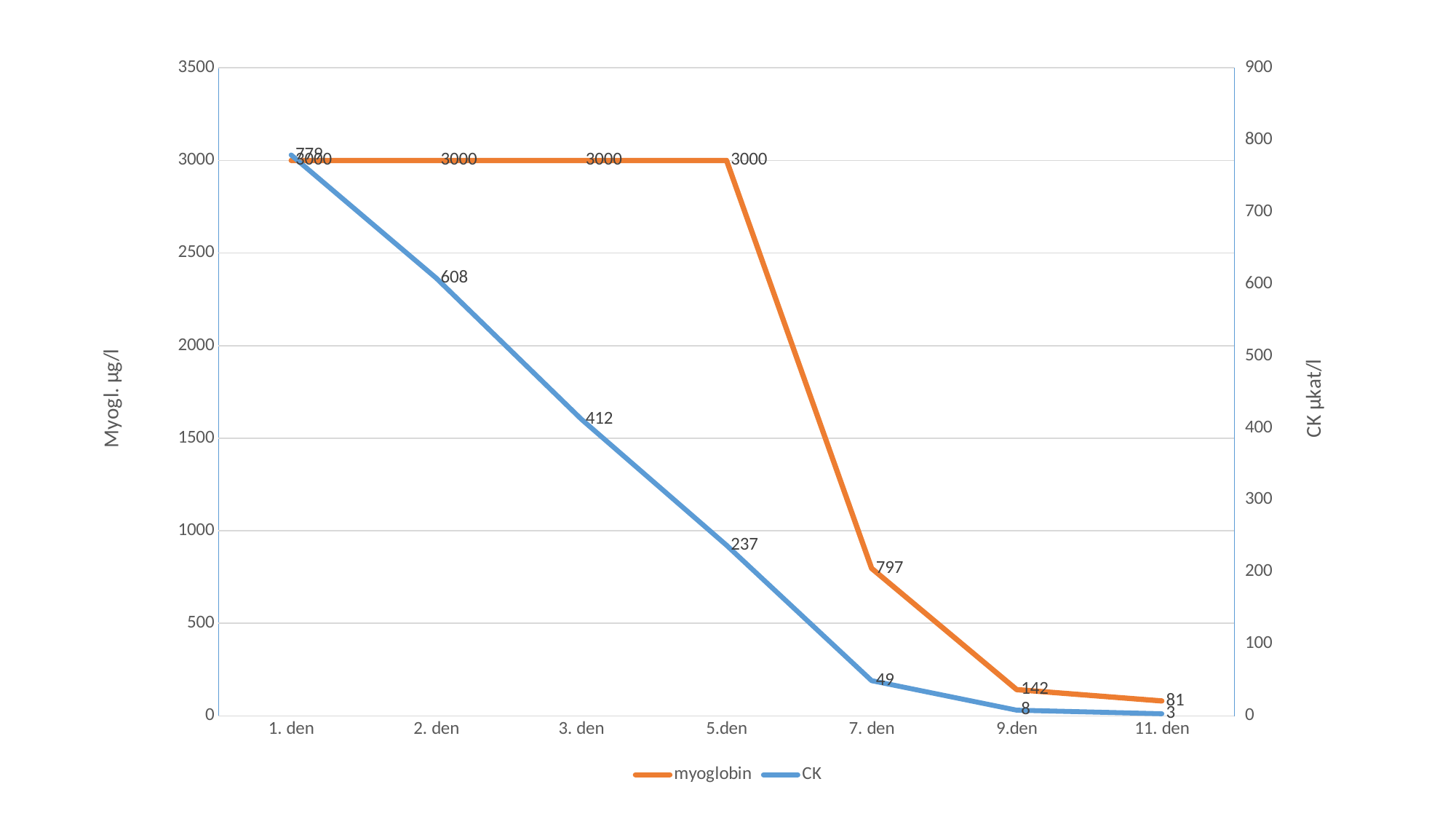
What is the difference between the myoglobin values on 7. den and 9.den? 655 What is the myoglobin value on 7. den? 797 What is the difference between the CK values on 2. den and 3. den? 196 How many series does the legend list? 2 What is the myoglobin value on 11. den? 81 What is the CK value on 3. den? 412 On which day is the CK value lowest? 11. den What is the CK value on 9.den? 8 Does the CK series rise or fall from 1. den to 11. den? fall What type of chart is shown on the slide? line chart How many points are plotted along the x axis for each series? 7 Which colour is used for the myoglobin line? orange